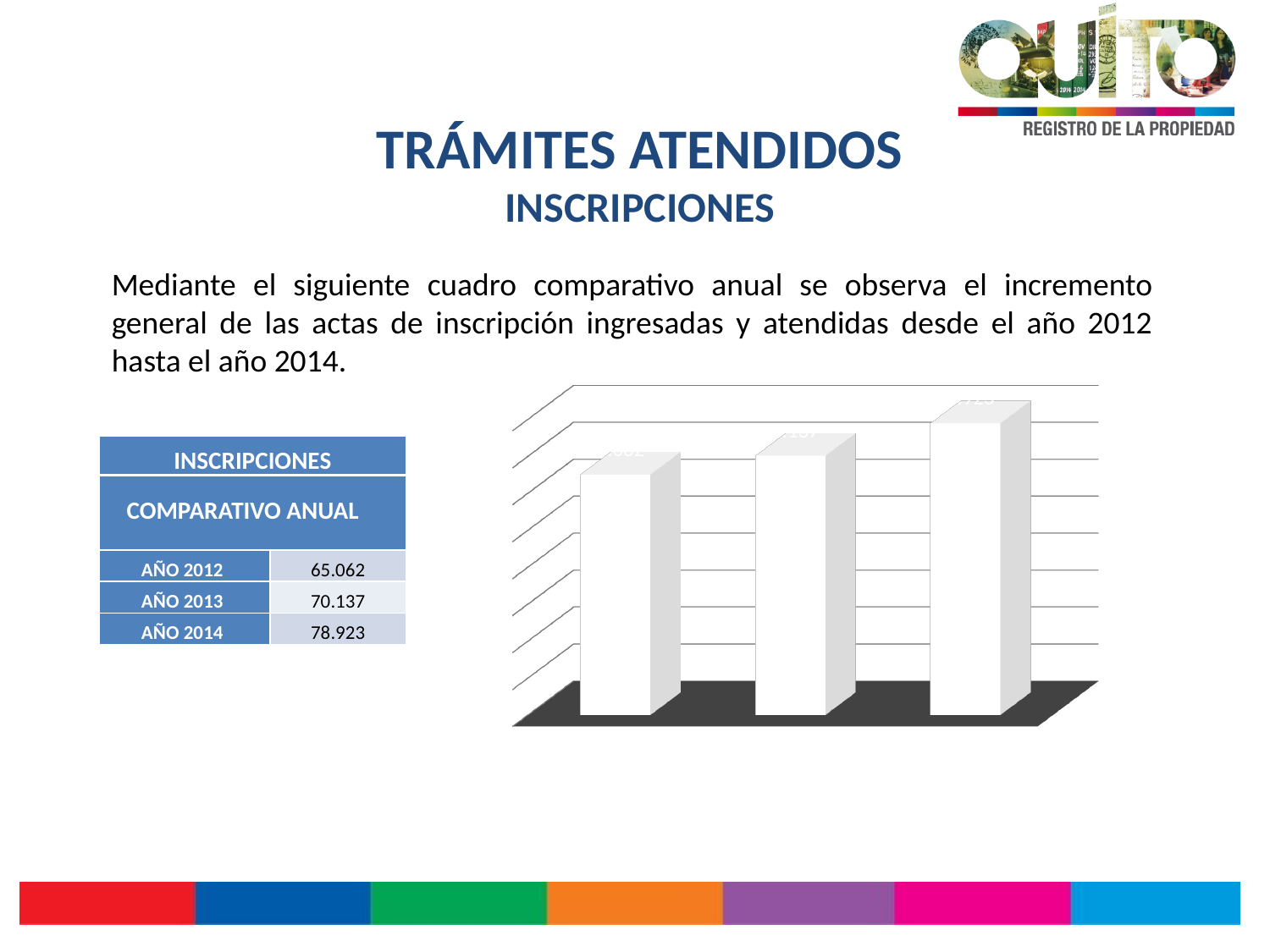
What is the title of the table that accompanies the chart? INSCRIPCIONES COMPARATIVO ANUAL What kind of chart is shown on the slide? bar chart Which bar is the shortest in the chart: the left, middle or right one? left Which bar is the tallest in the chart: the left, middle or right one? right Is the middle bar taller or shorter than the right bar? shorter How many bars are plotted in the chart? 3 According to the table next to the chart, which year has the highest number of inscripciones? AÑO 2014 According to the comparative table next to the chart, what is the number of inscripciones for AÑO 2012? 65.062 According to the table next to the chart, which year has the lowest number of inscripciones? AÑO 2012 Do the bar heights rise or fall from left to right across the chart? rise According to the comparative table next to the chart, what is the number of inscripciones for AÑO 2014? 78.923 According to the comparative table next to the chart, what is the number of inscripciones for AÑO 2013? 70.137